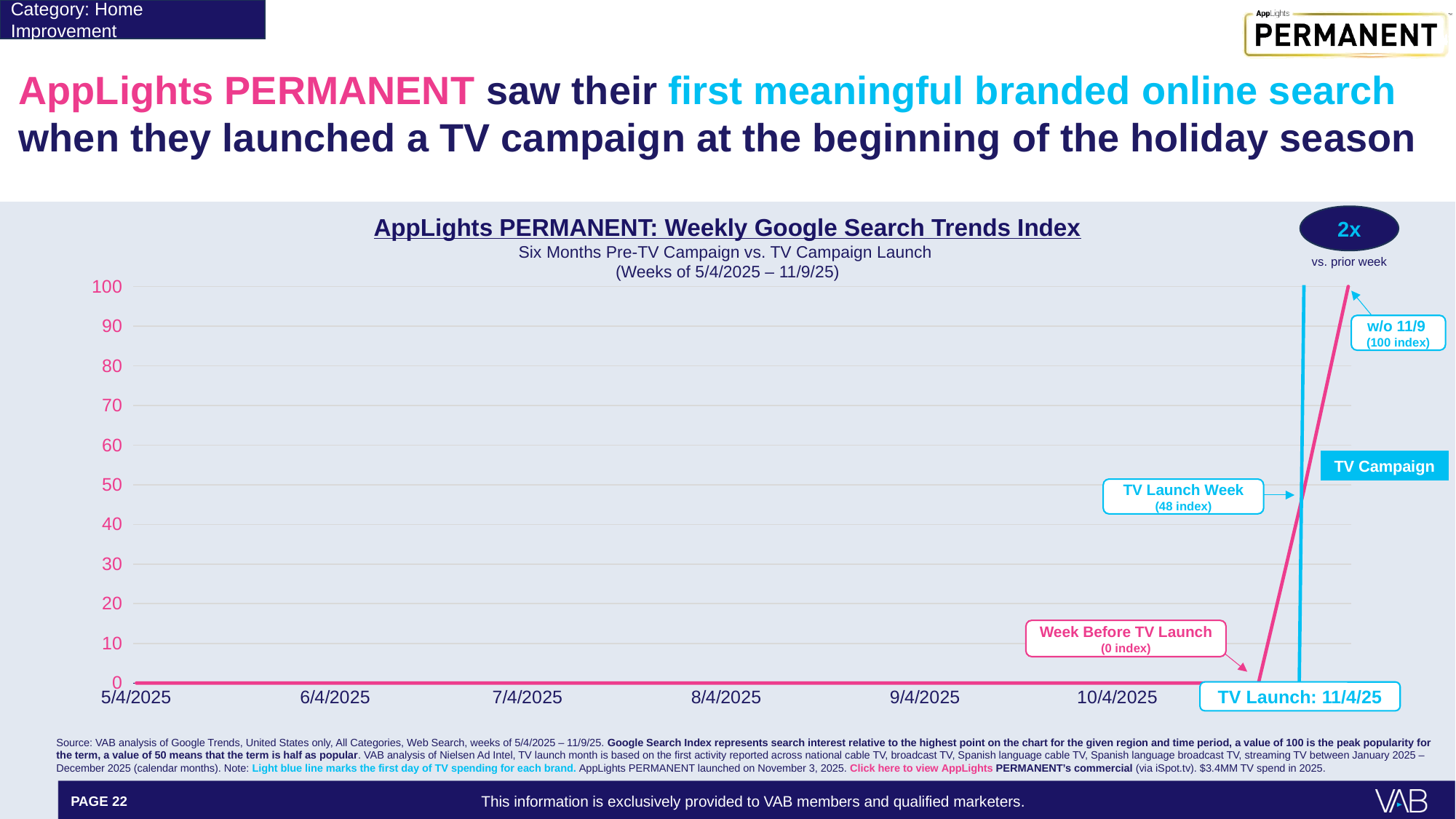
What date is given for the TV launch on the chart? 11/4/25 Does the search index rise or fall after the TV launch on 11/4/25? Rise What is the difference in search index between the week of 11/9 and the TV launch week? 52 Is the search index for the TV launch week greater or less than 40? greater What is the search index value for the week of 11/9? 100 What is the search index value for the week before the TV launch? 0 Which is larger, the search index for the TV launch week or for the week of 11/9? w/o 11/9 What is the search index value for the TV launch week? 48 What kind of chart is shown on the slide? Line chart Which labeled week has the highest search index value? w/o 11/9 What is the difference in search index between the TV launch week and the week before the TV launch? 48 What is the title of the chart? AppLights PERMANENT: Weekly Google Search Trends Index